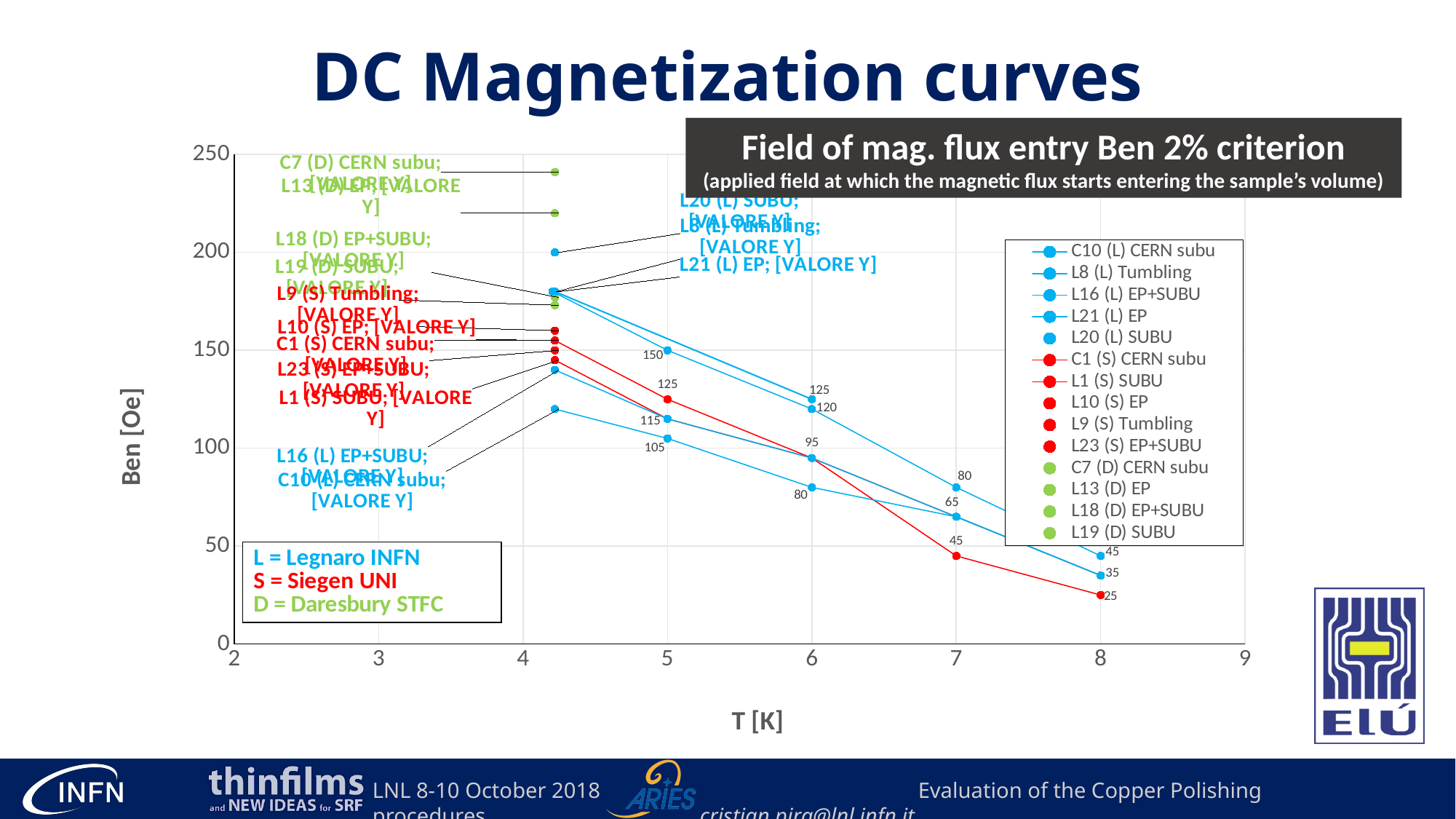
What is the lowest data label printed at T = 5 K? 105 What kind of chart is shown on the slide? line chart Which is larger, the highest labelled value at T = 7 K or the highest labelled value at T = 8 K? T = 7 K What is the highest data label printed at T = 5 K? 150 What is the title of the x axis? T [K] Do the Ben values rise or fall as T increases from 4 K to 8 K? fall How many data labels are printed at T = 8 K? 3 What is the highest data label printed at T = 6 K? 125 What is the difference between the highest (150) and lowest (105) labelled values at T = 5 K? 45 What is the title of the y axis? Ben [Oe] What is the lowest data label printed at T = 8 K? 25 How many series does the legend list? 14